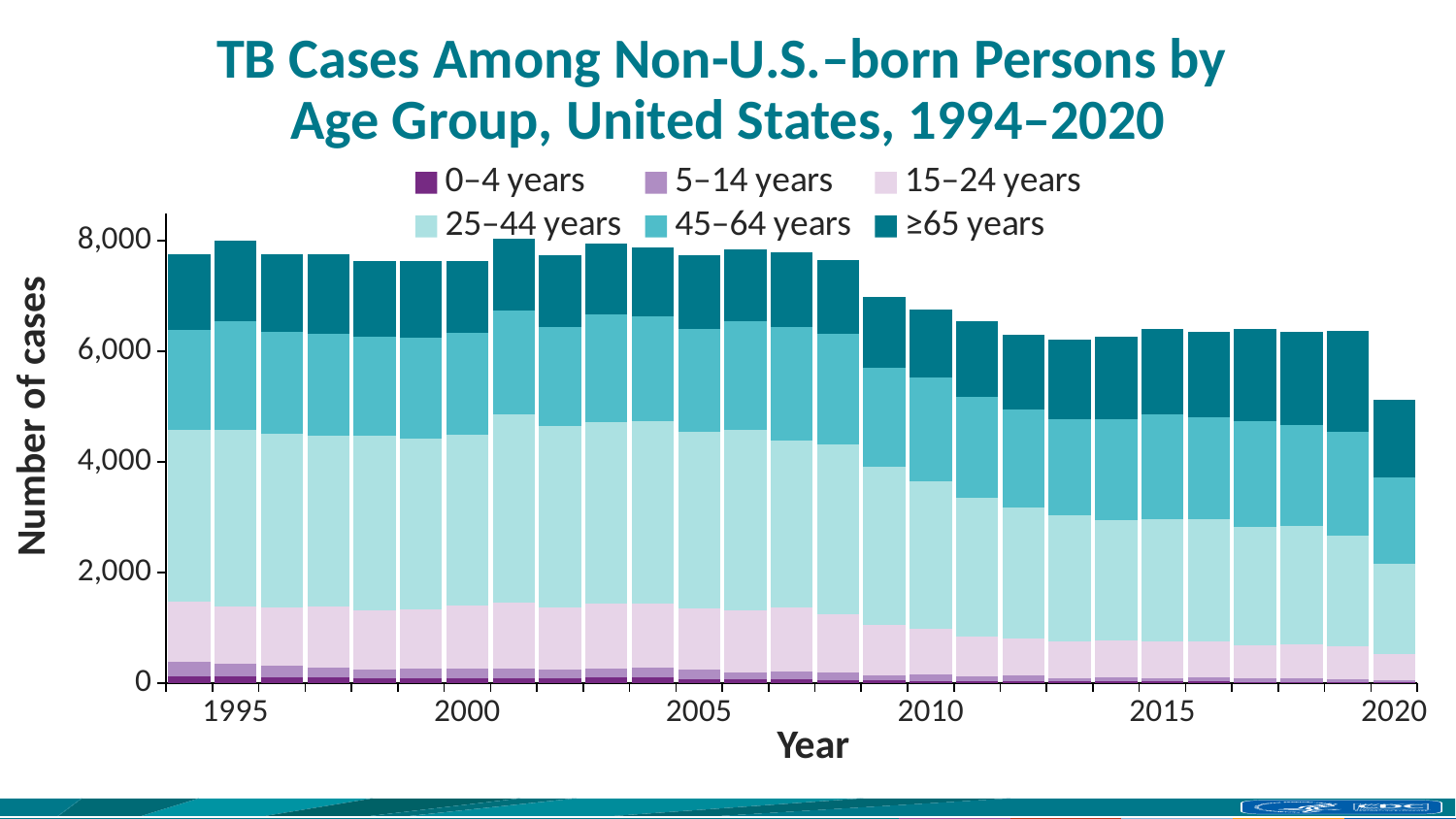
What kind of chart is shown on the slide? Stacked bar chart How many years (bars) are plotted in the chart? 27 How many age-group series does the legend list? 6 Is the total number of cases in 2020 greater or less than 4,000? greater Is the total number of cases in 2020 greater or less than 6,000? less Which year has the lowest total number of TB cases among non-U.S.-born persons? 2020 Overall, do the total TB cases rise or fall from 1994 to 2020? Fall Which year has the larger total number of cases, 2008 or 2009? 2008 Is the total number of cases in 2009 greater or less than 8,000? less Which year has the larger total number of cases, 2019 or 2020? 2019 What is the label on the y-axis of the chart? Number of cases